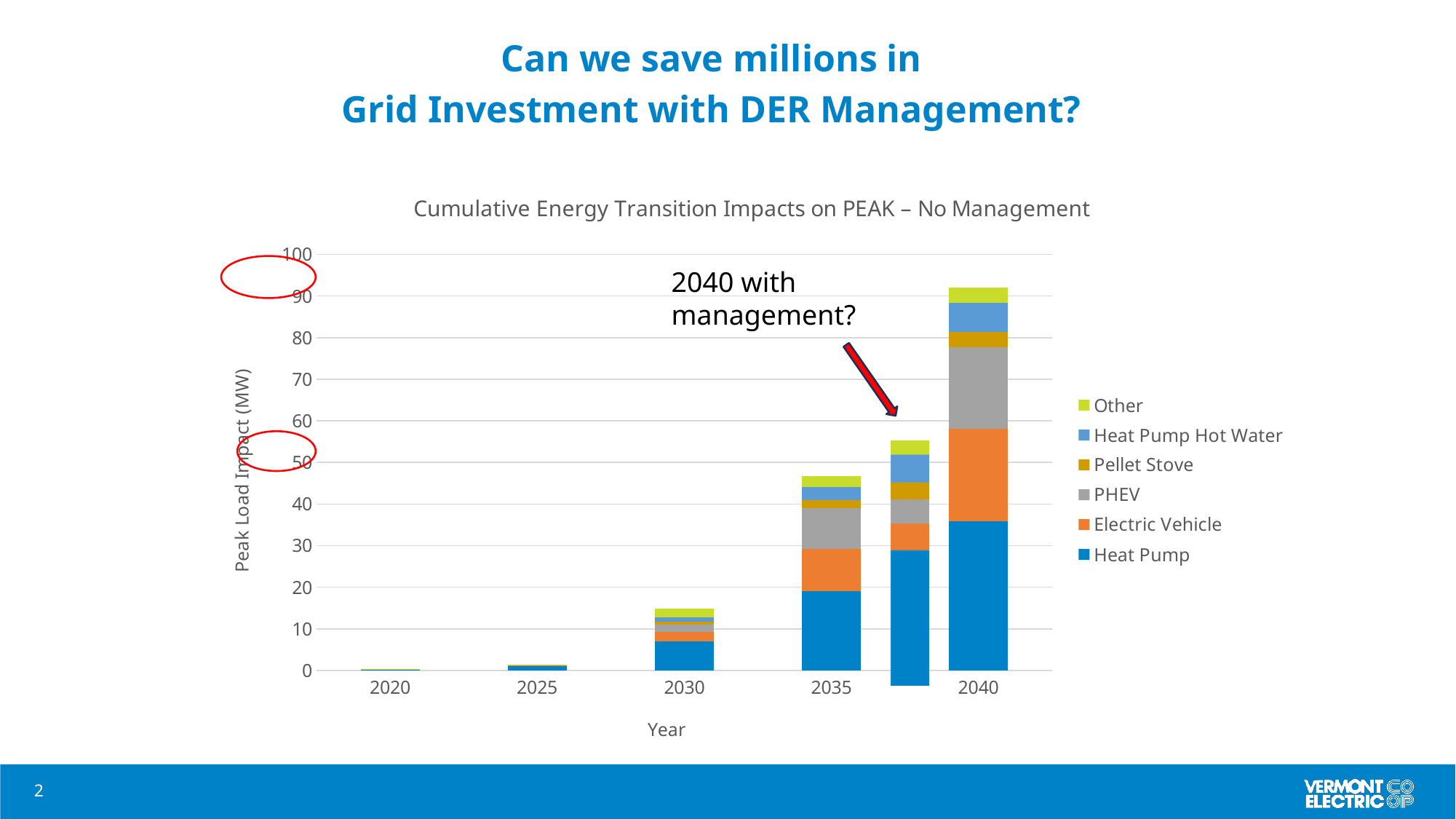
Is the total peak load impact for 2030 greater or less than 20 MW? less What kind of chart is shown on the slide? Stacked bar chart Which labeled year has the highest total peak load impact? 2040 Is the total peak load impact for 2040 greater or less than 80 MW? greater What is the title of the chart? Cumulative Energy Transition Impacts on PEAK – No Management Which is larger in 2040, the Heat Pump segment or the Electric Vehicle segment? Heat Pump How many labeled years are shown on the x axis? 5 Which labeled year has the lowest total peak load impact? 2020 Is the total peak load impact for 2035 greater or less than 40 MW? greater What is the label of the vertical axis? Peak Load Impact (MW) Do the total peak load impacts rise or fall from 2020 to 2040? Rise How many series does the legend list? 6